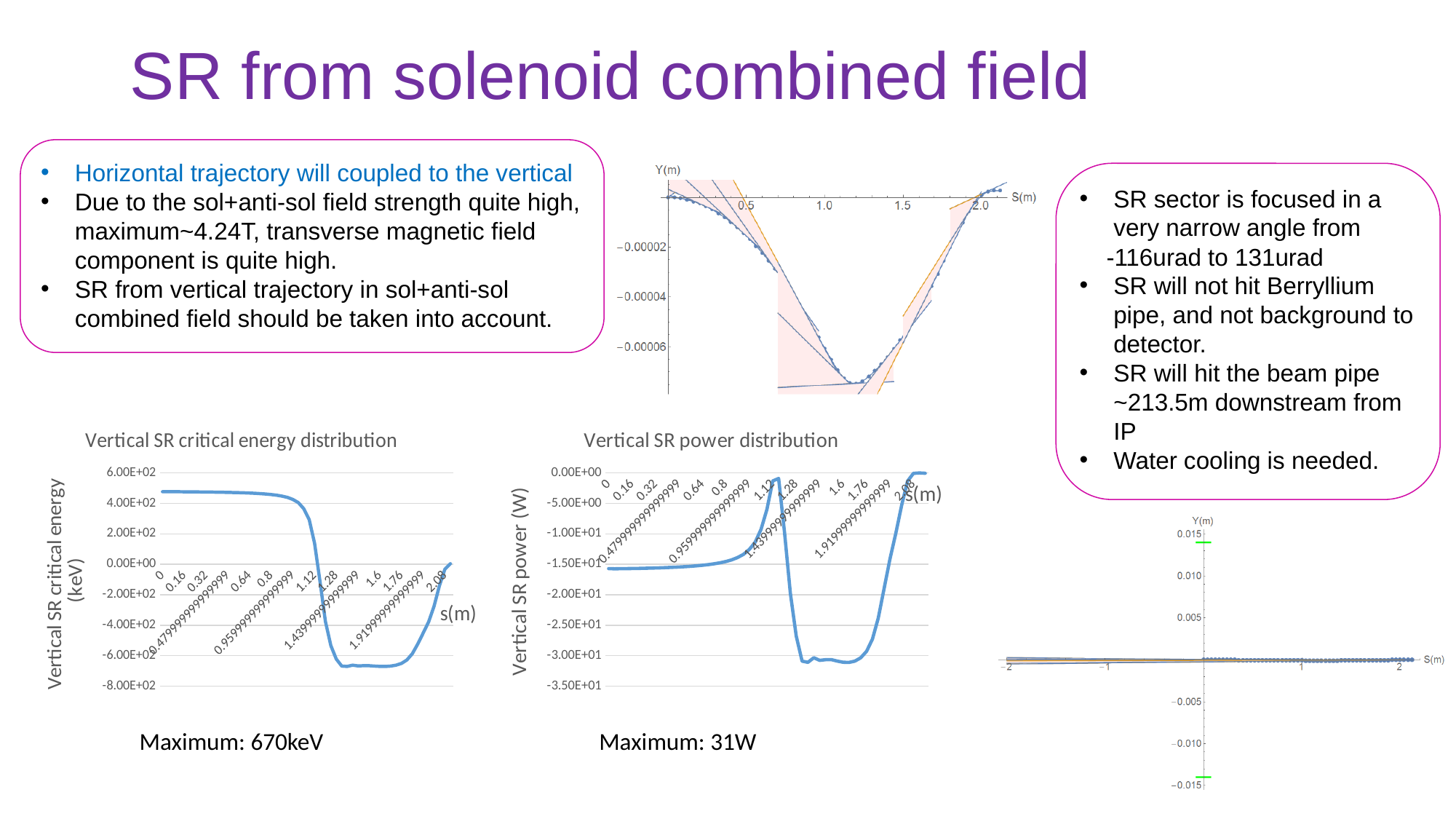
What kind of chart is the 'Vertical SR critical energy distribution' chart? line chart In the 'Vertical SR critical energy distribution' chart, is the value at s = 1.6 greater or less than -4.00E+02? less In the 'Vertical SR power distribution' chart, is the value at s = 0 greater or less than -1.00E+01? less In the 'Vertical SR power distribution' chart, is the value at s = 1.6 greater or less than -2.50E+01? less What is the y-axis title of the 'Vertical SR power distribution' chart? Vertical SR power (W) What kind of chart is the 'Vertical SR power distribution' chart? line chart In the 'Vertical SR power distribution' chart, do the values rise or fall between s = 1.76 and s = 2.08? rise In the 'Vertical SR critical energy distribution' chart, which is larger, the value at s = 0 or the value at s = 1.6? s = 0 What maximum value is stated below the 'Vertical SR critical energy distribution' chart? 670keV In the 'Vertical SR critical energy distribution' chart, do the values rise or fall between s = 0.8 and s = 1.28? fall